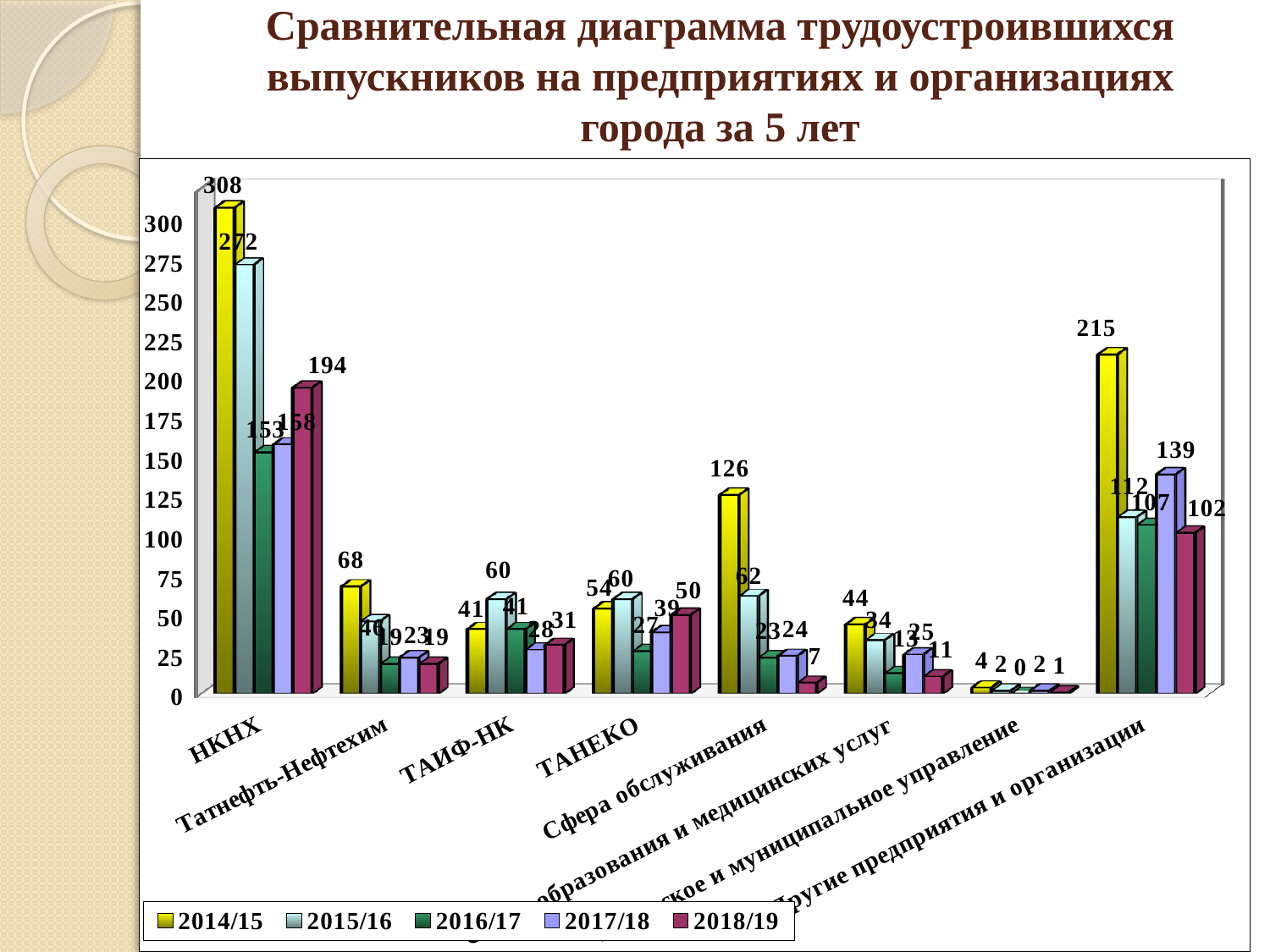
What is the value for Другие предприятия и организации in 2014/15? 215 What is the difference between the 2014/15 and 2015/16 values for НКНХ? 36 What is the value for Другие предприятия и организации in 2017/18? 139 Which is larger in 2018/19: НКНХ or Другие предприятия и организации? НКНХ What is the value for НКНХ in 2014/15? 308 Is the value for Татнефть-Нефтехим in 2014/15 greater or less than 50? greater What is the difference between the 2014/15 and 2018/19 values for Другие предприятия и организации? 113 How many series does the legend list? 5 Which category has the highest value for 2014/15? НКНХ What is the value for Сфера обслуживания in 2014/15? 126 What kind of chart is shown on the slide? bar chart How many categories are shown on the x axis? 8